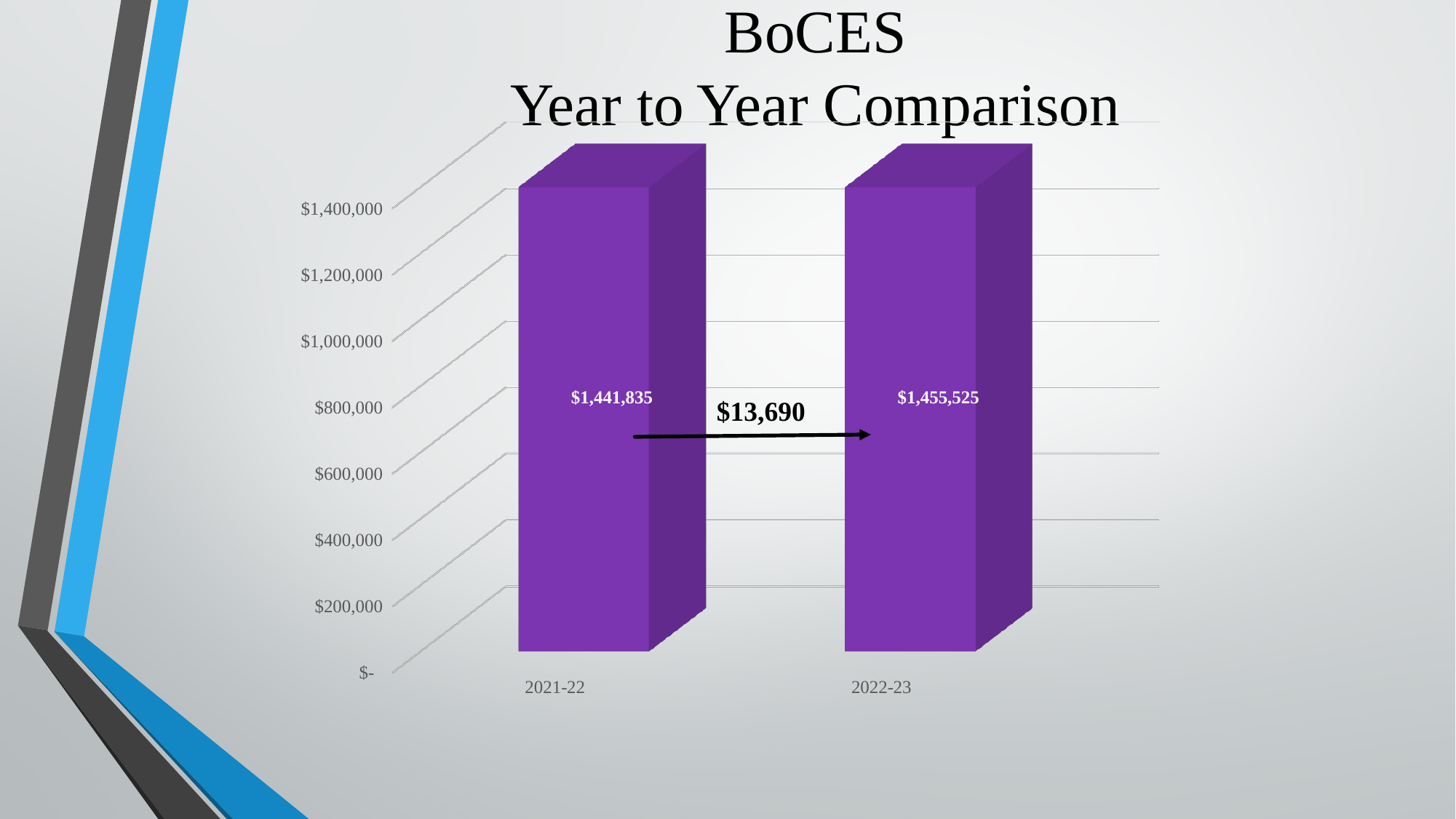
What kind of chart is shown on the slide? Bar chart Is the value for 2022-23 greater or less than $1,200,000? greater What is the title of the chart? BoCES Year to Year Comparison What is the difference between the 2022-23 value and the 2021-22 value? $13,690 Is the value for 2021-22 greater or less than $1,400,000? greater What is the value for 2022-23? $1,455,525 Do the values rise or fall from 2021-22 to 2022-23? Rise How many categories are shown on the x axis? 2 What is the value for 2021-22? $1,441,835 Which category has the highest value? 2022-23 Which year has the higher value, 2021-22 or 2022-23? 2022-23 Which category has the lowest value? 2021-22